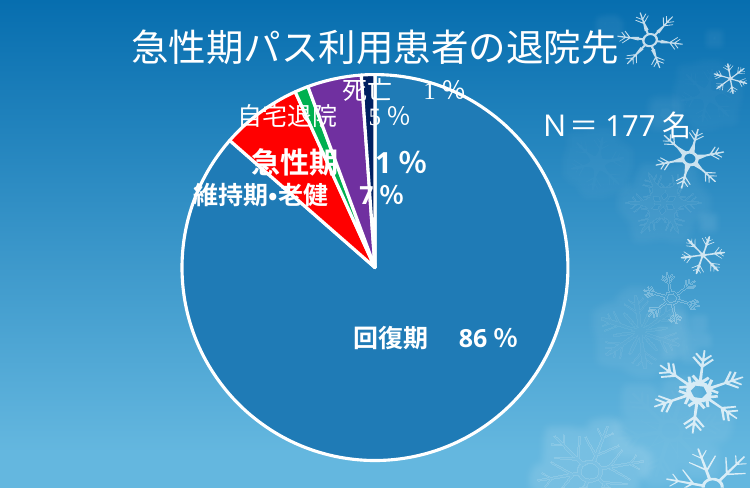
What is the title of the chart? 急性期パス利用患者の退院先 What is the share for 回復期? 86％ Which is larger, the share for 自宅退院 or the share for 維持期・老健? 維持期・老健 What is the share for 自宅退院? 5％ What is the share for 急性期? 1％ What kind of chart is shown on the slide? pie chart What is the share for 死亡? 1％ How many categories (slices) does the pie chart have? 5 Which category has the largest share of the pie? 回復期 What is the sample size (N) shown on the slide? 177名 What is the share for 維持期・老健? 7％ What is the difference in percentage points between 回復期 and 維持期・老健? 79